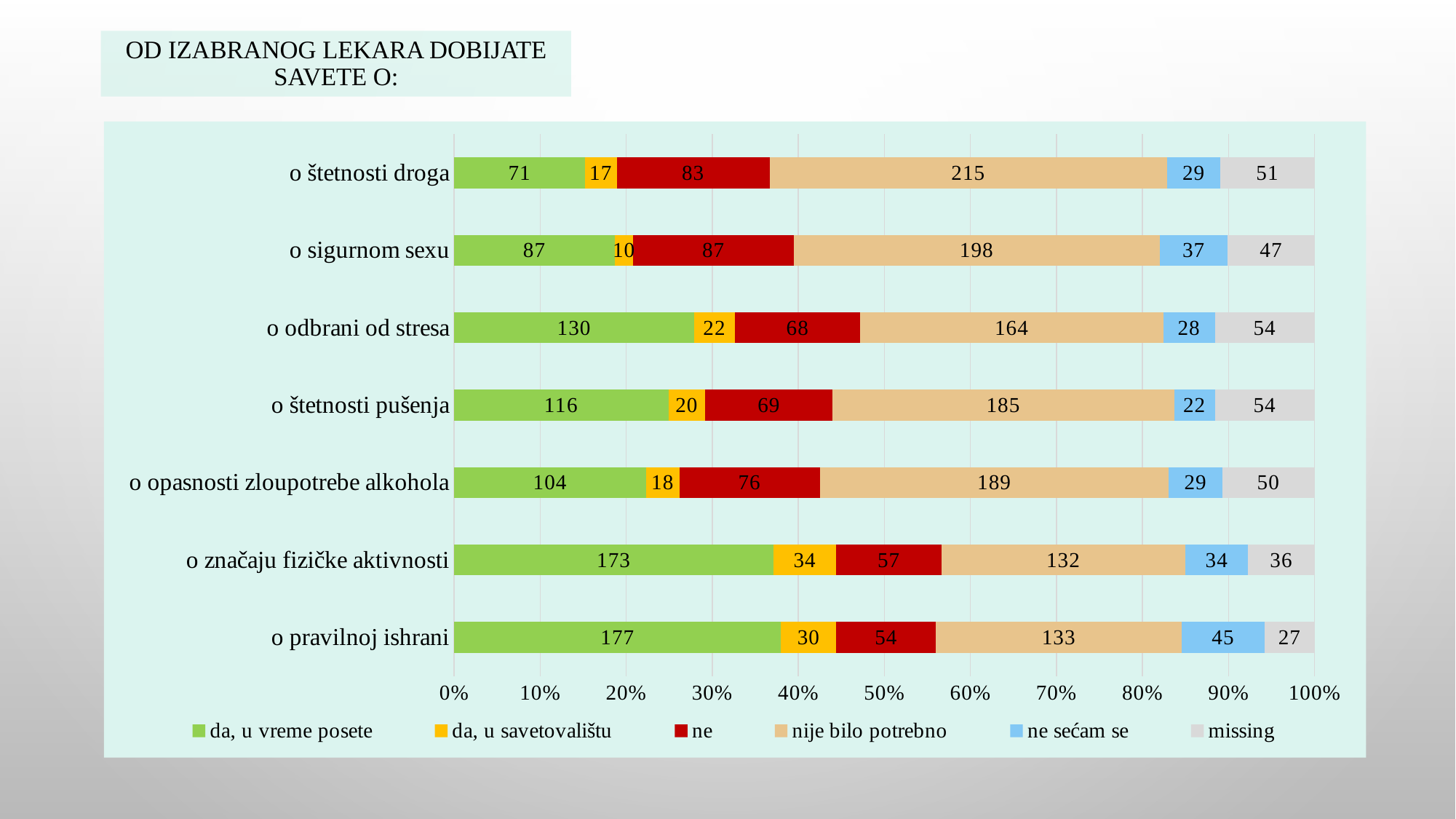
Which category has the highest value for "da, u vreme posete"? o pravilnoj ishrani Which category has the lowest value for "da, u savetovalištu"? o sigurnom sexu What kind of chart is shown on the slide? stacked bar chart What is the "missing" value for "o značaju fizičke aktivnosti"? 36 Which is larger: the "nije bilo potrebno" value for "o štetnosti pušenja" or for "o odbrani od stresa"? o štetnosti pušenja How many categories are shown on the y axis? 7 What is the difference between the "ne" values for "o sigurnom sexu" and "o pravilnoj ishrani"? 33 What is the value of "ne sećam se" for "o sigurnom sexu"? 37 How many series does the legend list? 6 What is the value of "nije bilo potrebno" for "o štetnosti droga"? 215 What is the total of all segments in the bar for "o odbrani od stresa"? 466 What is the value of "da, u vreme posete" for "o pravilnoj ishrani"? 177